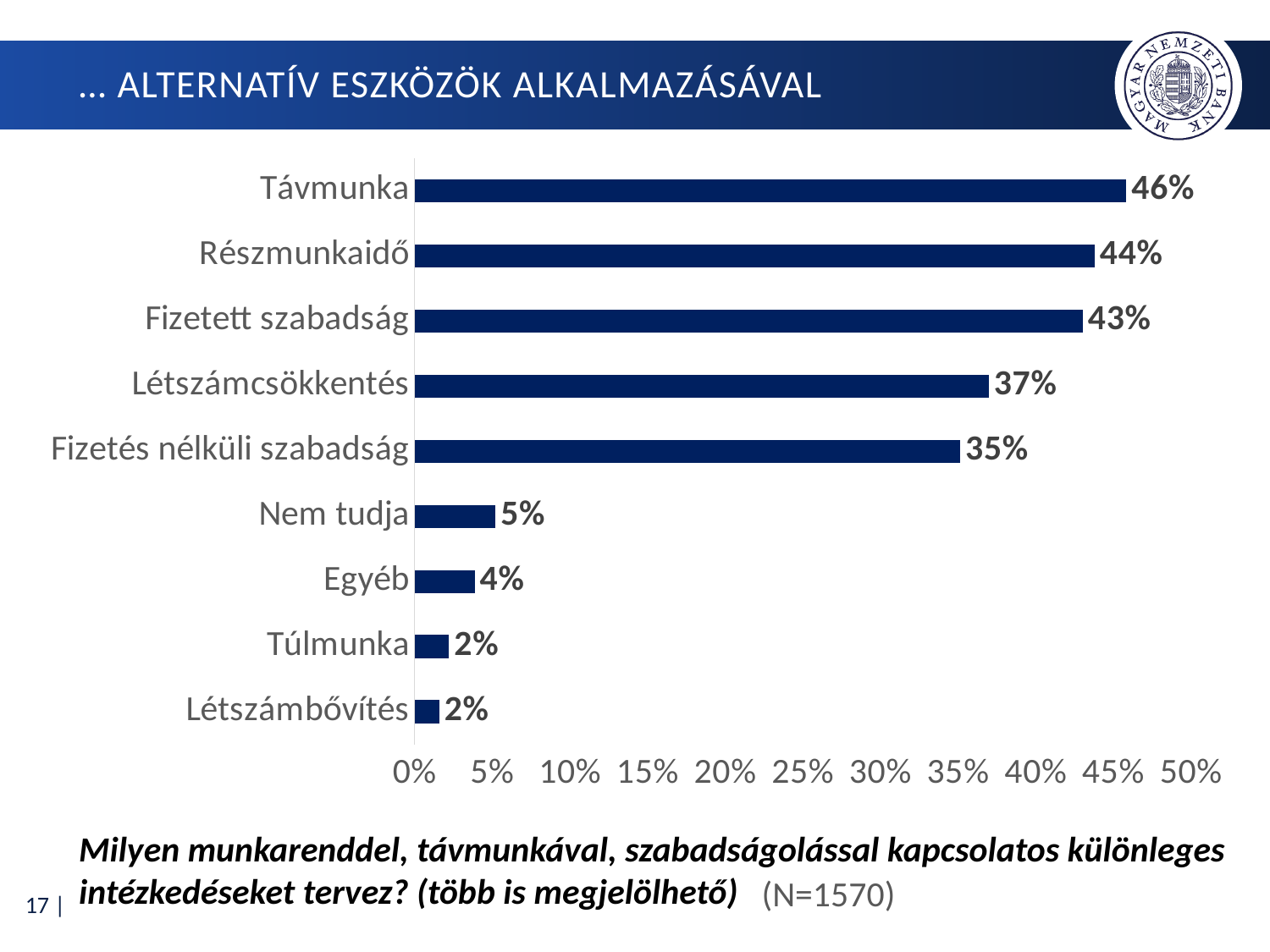
Is the value for Létszámcsökkentés greater or less than 40%? less What is the difference between the values for Nem tudja and Egyéb? 1% What kind of chart is shown on the slide? bar chart How many categories are shown in the chart? 9 What is the value for Fizetés nélküli szabadság? 35% What is the highest value shown on the x axis? 50% Which is larger, the value for Részmunkaidő or the value for Fizetett szabadság? Részmunkaidő What is the difference between the values for Távmunka and Fizetés nélküli szabadság? 11% What is the value for Nem tudja? 5% What is the value for Létszámcsökkentés? 37% What is the value for Távmunka? 46% Which category has the highest value? Távmunka